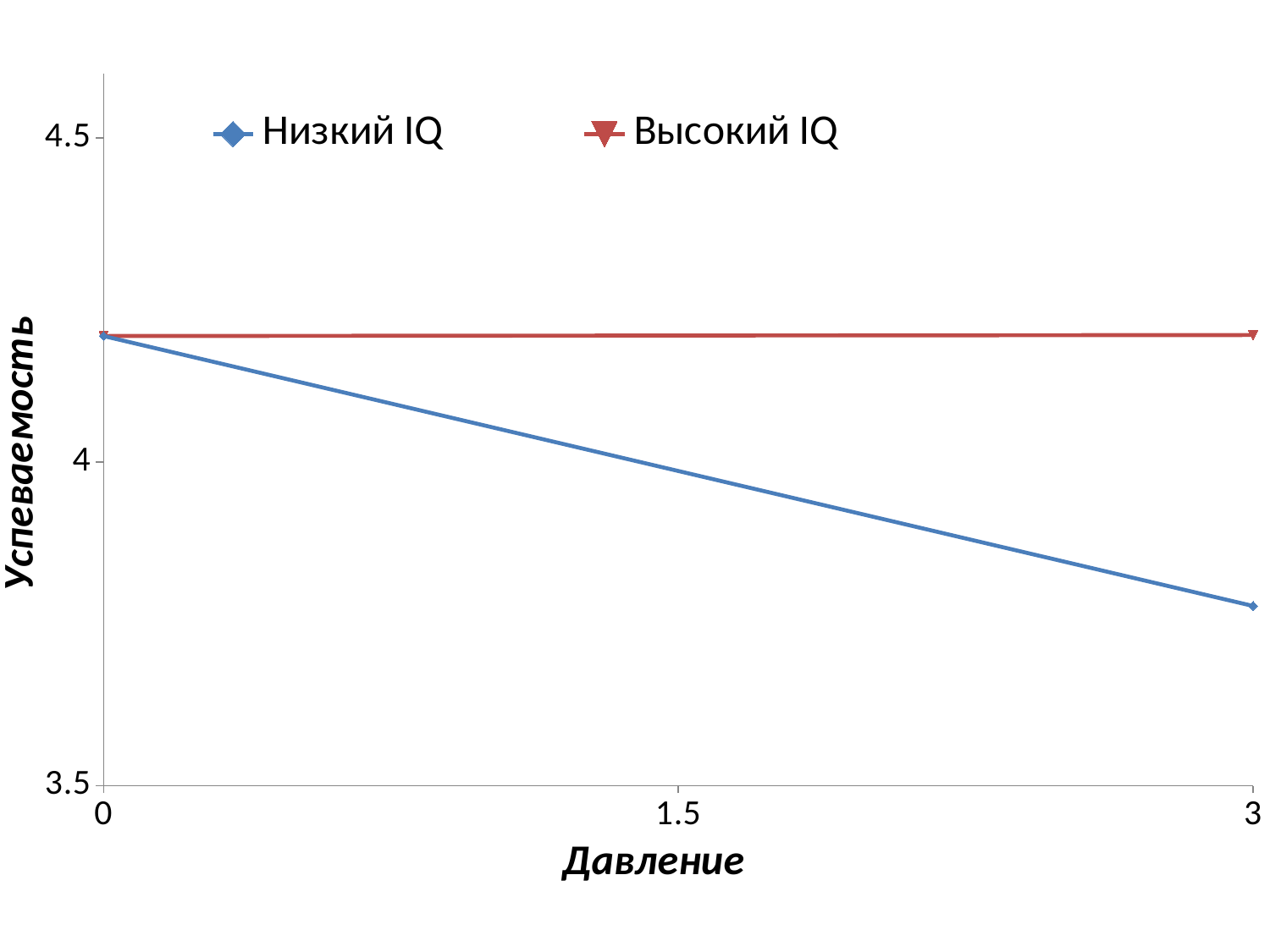
Is the value for Низкий IQ at Давление 0 greater or less than 4? greater Does the Высокий IQ line rise, fall or stay roughly flat as Давление increases from 0 to 3? stays roughly flat Which series has the lowest value at Давление 3? Низкий IQ At Давление 3, which series has the higher value, Низкий IQ or Высокий IQ? Высокий IQ Is the value for Низкий IQ at Давление 3 greater or less than 4? less Which series are listed in the legend? Низкий IQ, Высокий IQ How many series does the legend list? 2 Is the value for Высокий IQ at Давление 3 greater or less than 4? greater How many data points does each line have? 2 What kind of chart is shown on the slide? line chart Does the Низкий IQ line rise or fall as Давление increases from 0 to 3? fall What is the title of the x axis? Давление